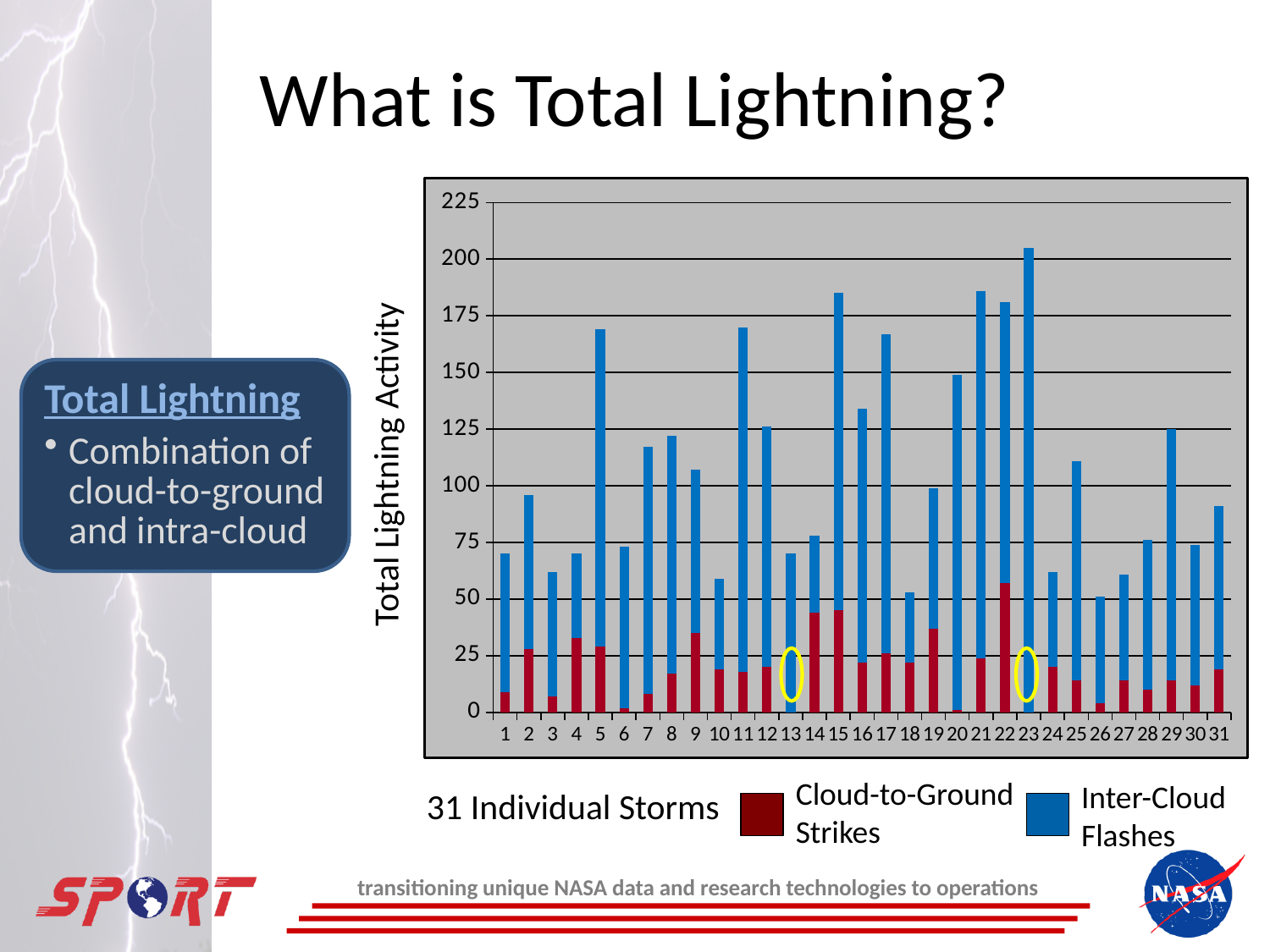
How many individual storms (categories) are plotted on the x axis? 31 Is the total lightning activity for storm 15 greater or less than 175? greater Is the total lightning activity for storm 5 greater or less than 150? greater Is the total lightning activity for storm 3 greater or less than 75? less Which has the larger total lightning activity, storm 5 or storm 6? storm 5 Which series is shown in dark red in the legend? Cloud-to-Ground Strikes How many series does the legend list? 2 Which storm has the highest total lightning activity? 23 What kind of chart is shown on the slide? stacked bar chart Which has the larger total lightning activity, storm 11 or storm 12? storm 11